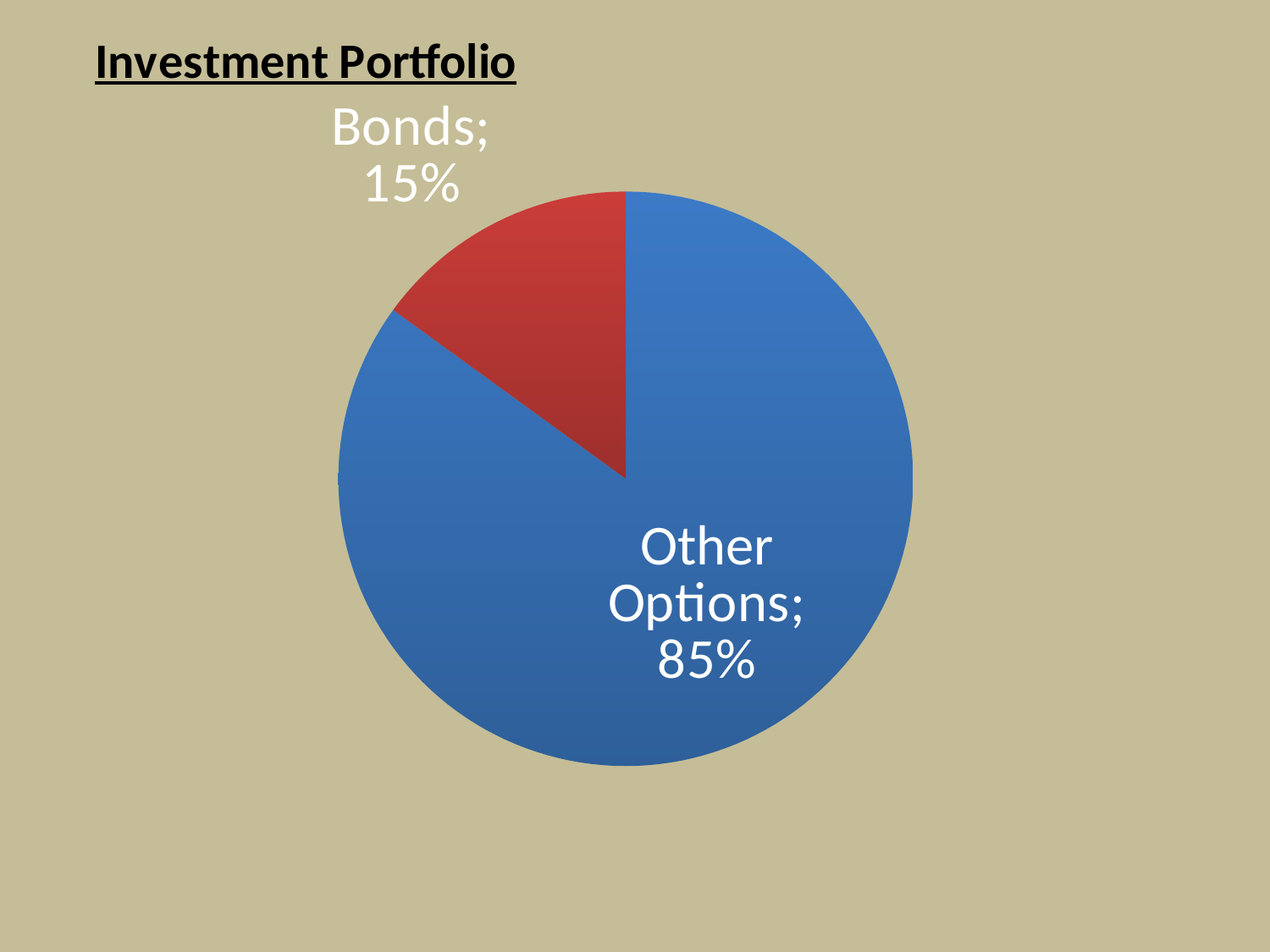
Which slice of the pie is the largest? Other Options Which slice of the pie is the smallest? Bonds What kind of chart is shown on the slide? pie chart How many slices does the pie chart have? 2 What colour is the Bonds slice of the pie? red What share of the Investment Portfolio pie is Other Options? 85% What share of the Investment Portfolio pie is Bonds? 15% What is the difference in percentage points between Other Options and Bonds? 70 Which is larger, the Bonds slice or the Other Options slice? Other Options What is the title shown above the pie chart? Investment Portfolio